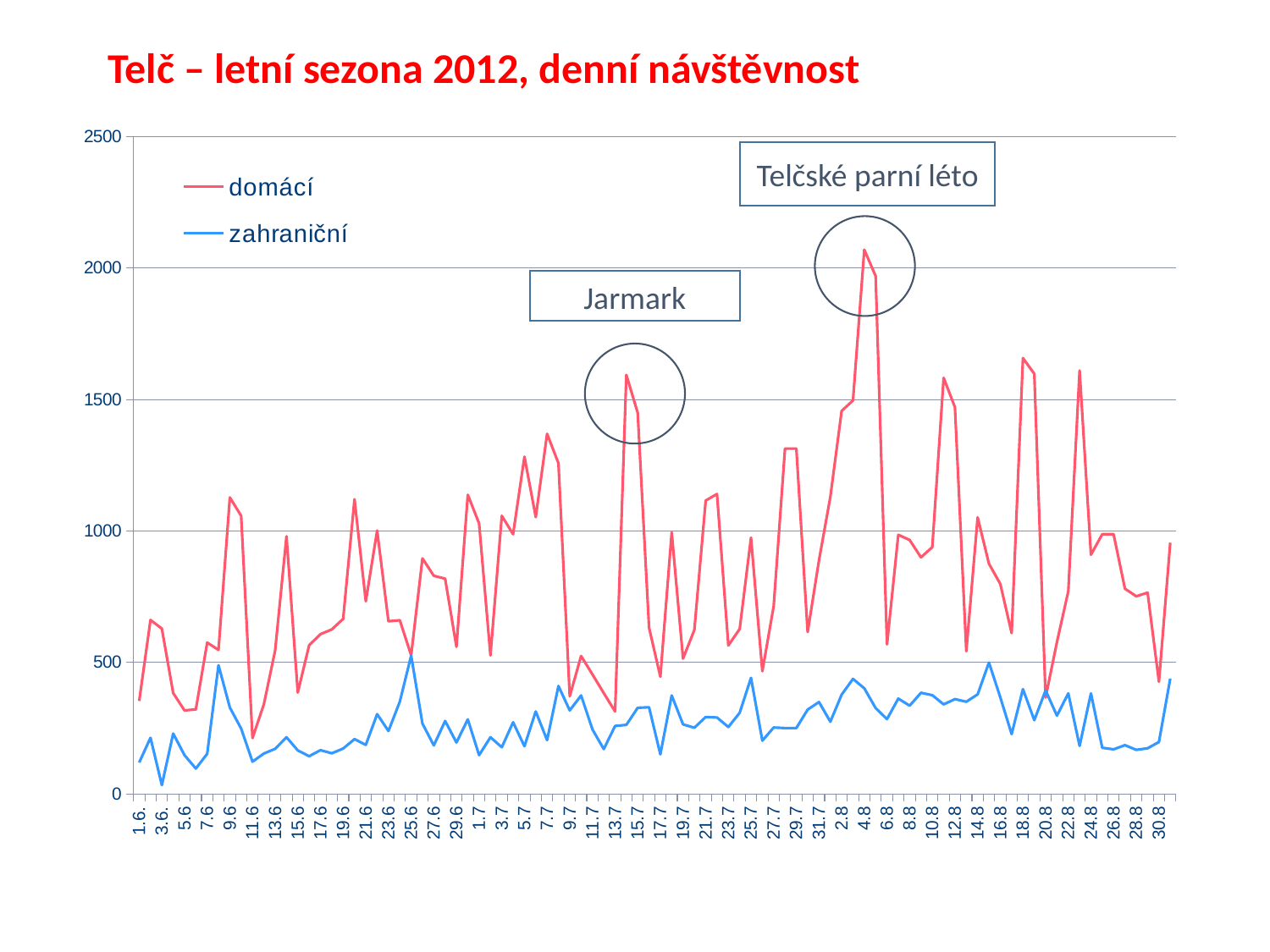
Is the domácí value on 11.6 greater or less than 500? less Which event label is attached to the highest peak of the domácí series? Telčské parní léto Which series generally has the lower values across the season? zahraniční What kind of chart is shown on the slide? line chart Is the zahraniční value on 1.6 greater or less than 500? less Which series reaches the highest value on the chart? domácí Is the domácí value on 1.6 greater or less than 500? less What are the two series named in the legend? domácí and zahraniční On 4.8, which series has the larger value, domácí or zahraniční? domácí How many series does the legend list? 2